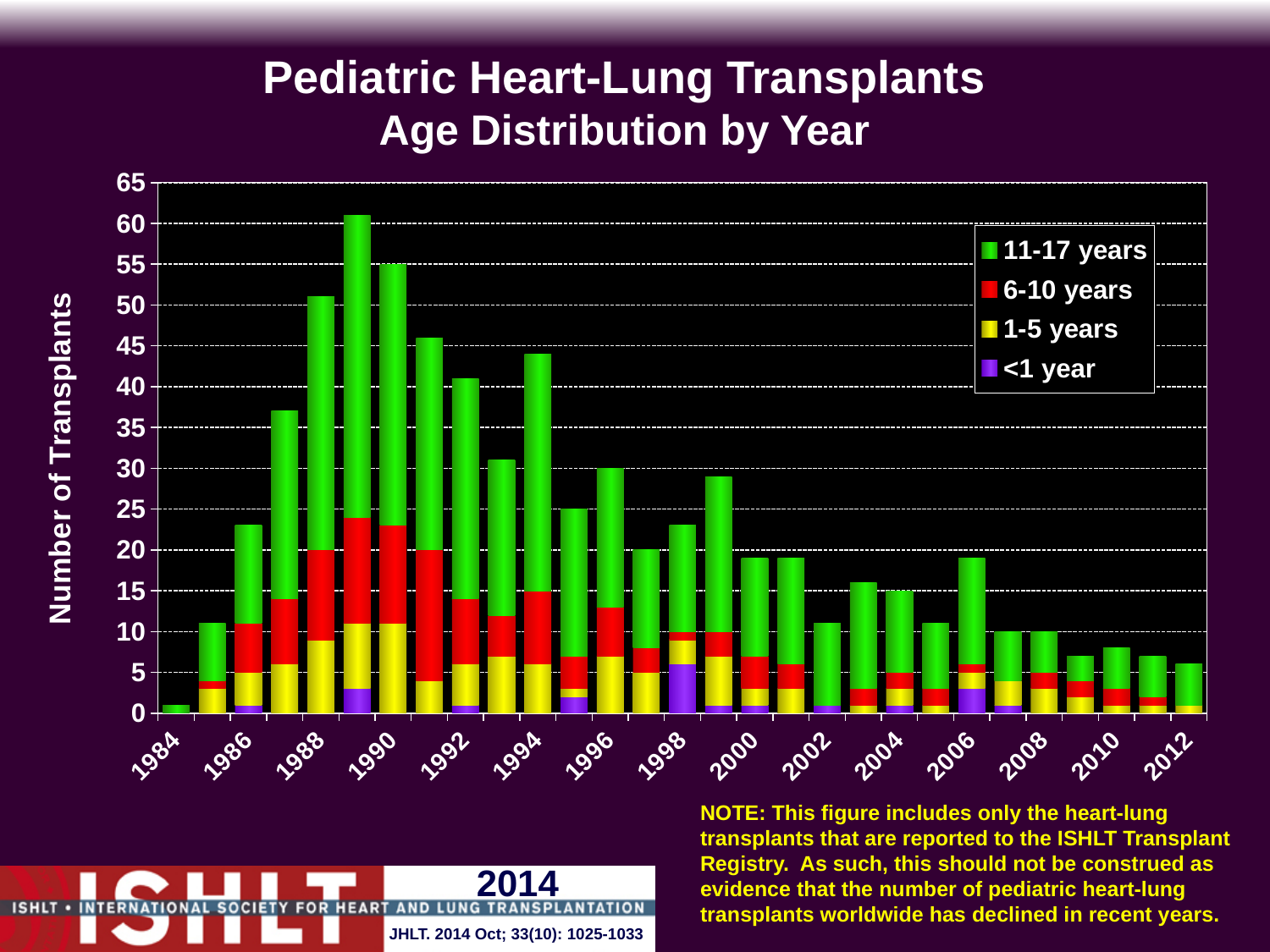
Do the total numbers of transplants generally rise or fall from 1989 to 2012? fall Is the total number of transplants for 2012 greater or less than 10? less Which year has the lowest total number of transplants? 1984 Which year has the highest total number of transplants? 1989 Is the total number of transplants for 1989 greater or less than 55? greater What kind of chart is shown on the slide? stacked bar chart Which age group is listed first (at the top) in the legend? 11-17 years Is the total number of transplants for 1984 greater or less than 5? less Which year has a higher total number of transplants, 1995 or 1996? 1996 How many years (bars) are plotted on the x axis? 29 How many series does the legend list? 4